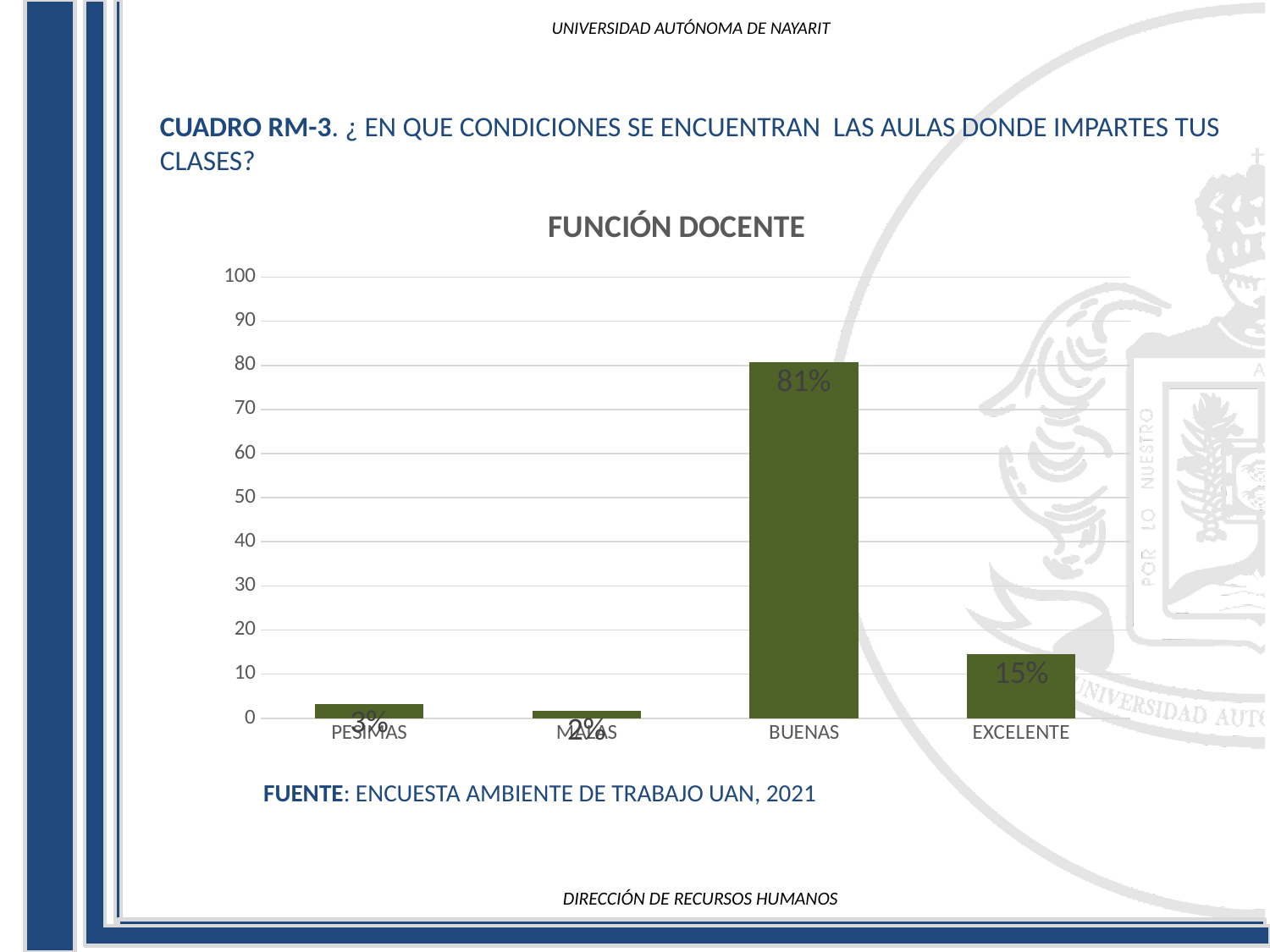
What is the value for PÉSIMAS? 3% What is the title of the chart? FUNCIÓN DOCENTE What is the value for MALAS? 2% What is the value for BUENAS? 81% Which is larger, the value for EXCELENTE or the value for PÉSIMAS? EXCELENTE Which category has the lowest value? MALAS How many categories are shown on the x axis? 4 What is the value for EXCELENTE? 15% Is the value for BUENAS greater or less than 70? greater What is the difference between the values for BUENAS and EXCELENTE? 66% Which category has the highest value? BUENAS What kind of chart is shown on the slide? bar chart